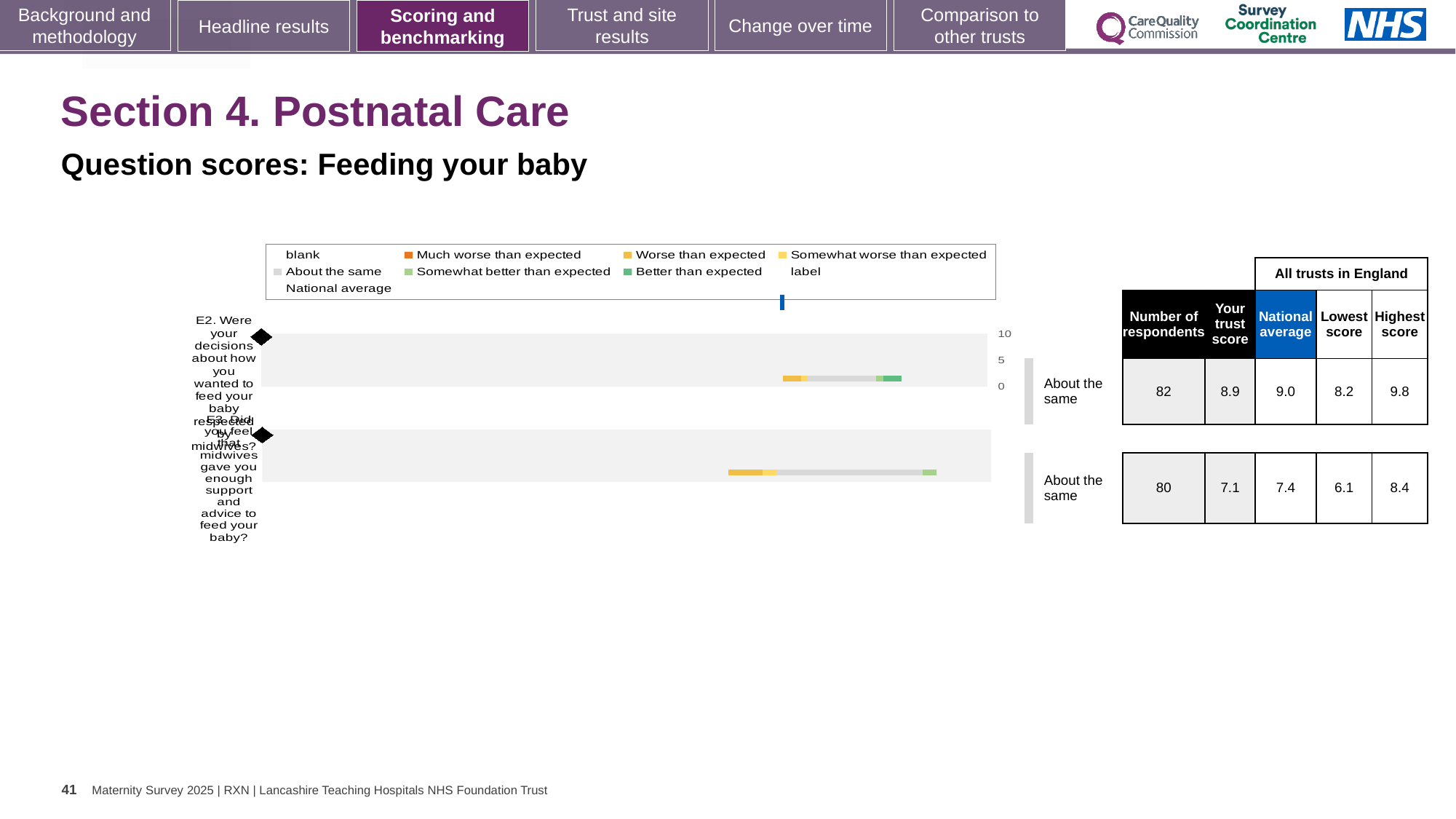
How many questions (categories) are plotted in the chart? 2 What is the trust score for E2 in the table beside the chart? 8.9 What is the benchmark category shown next to the bar for E2 (decisions about how you wanted to feed your baby respected by midwives)? About the same How many respondents answered E2 according to the table beside the chart? 82 What is the difference between the highest score and the lowest score for E3 across all trusts in England? 2.3 Which question has the higher trust score, E2 or E3? E2 What is the national average for E3 in the table beside the chart? 7.4 What is the trust score for E3 in the table beside the chart? 7.1 What is the benchmark category shown next to the bar for E3 (midwives gave you enough support and advice to feed your baby)? About the same What kind of chart is shown on the slide? Bar chart What is the difference between the trust scores for E2 and E3? 1.8 What is the maximum value shown on the chart's numeric axis? 10